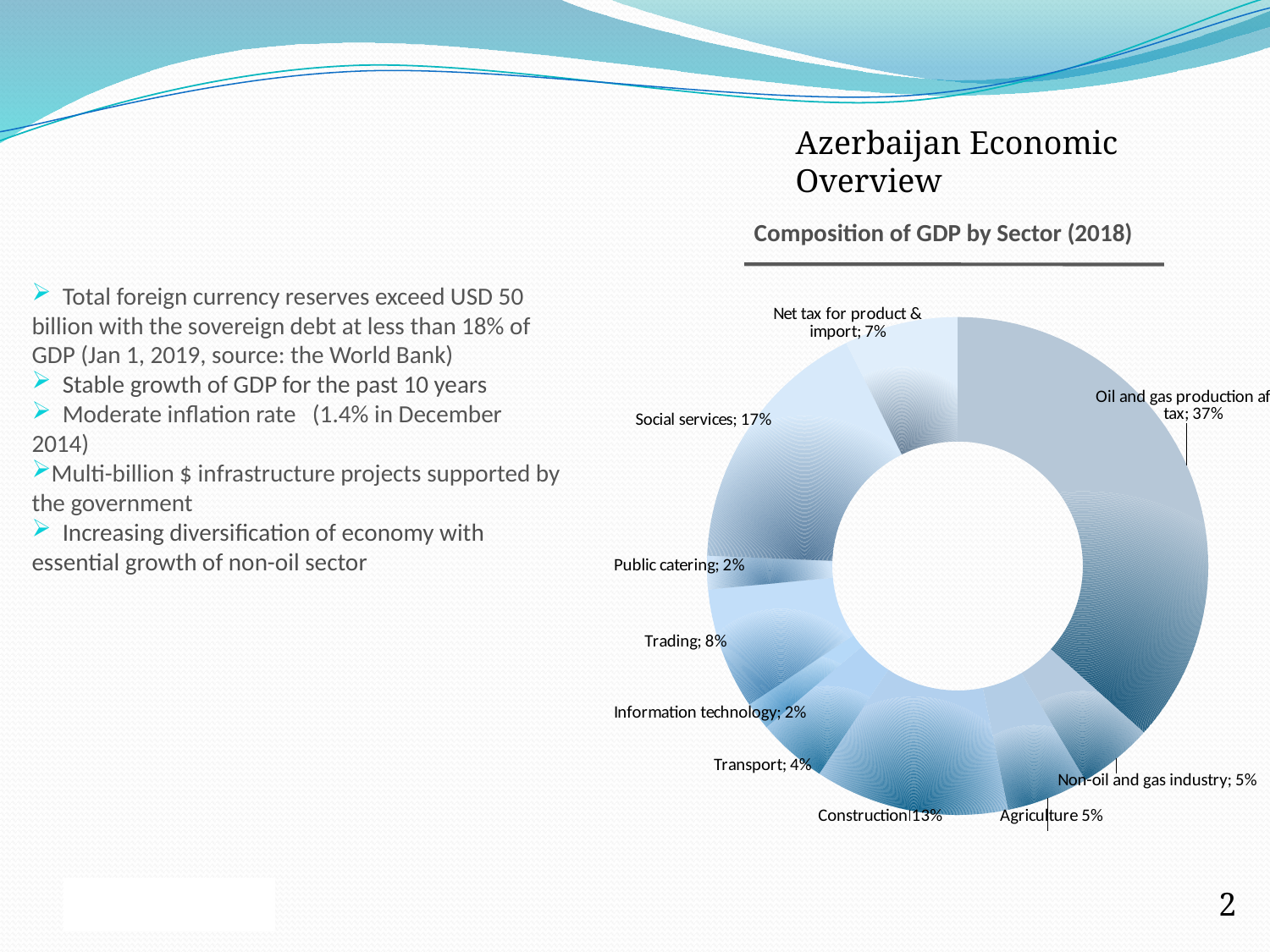
What share does Trading have in the Composition of GDP by Sector (2018) chart? 8% What type of chart is used to show the Composition of GDP by Sector (2018)? Doughnut chart How many percentage points larger is Social services than Construction? 4 percentage points Which is larger, Trading or Net tax for product & import? Trading What is the value for Non-oil and gas industry in the chart? 5% What percentage is shown for Net tax for product & import? 7% What is the value for Transport in the chart? 4% What is the value shown for Construction in the chart? 13% What percentage of GDP does Social services account for in the Composition of GDP by Sector (2018) chart? 17% Which sector has the largest share of GDP in the chart? Oil and gas production (37%) How many sectors are shown in the Composition of GDP by Sector (2018) chart? 10 What is the title of the chart on the slide? Composition of GDP by Sector (2018)